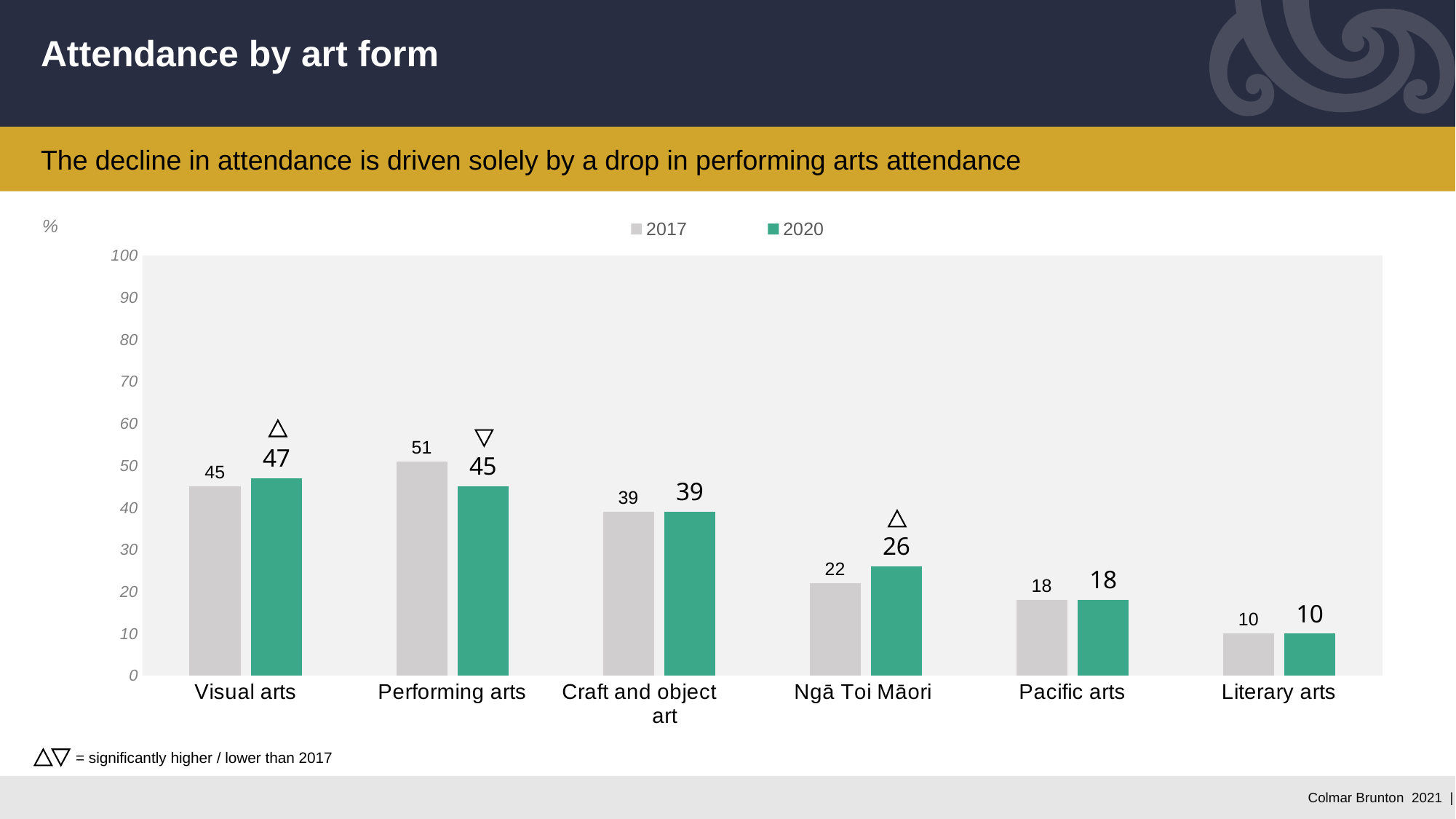
What kind of chart is shown on the slide? Bar chart Which art form has the highest 2017 value? Performing arts What is the 2020 value for Visual arts? 47 How many series does the legend list? 2 What is the 2020 value for Ngā Toi Māori? 26 Do the 2020 values rise or fall from Visual arts to Literary arts along the x axis? Fall Which art form has the lowest 2020 value? Literary arts What is the difference between the 2017 and 2020 values for Performing arts? 6 What is the 2017 value for Performing arts? 51 How many art form categories are shown on the x axis? 6 Which years are listed in the chart legend? 2017 and 2020 Which is larger for Ngā Toi Māori, the 2017 value or the 2020 value? 2020